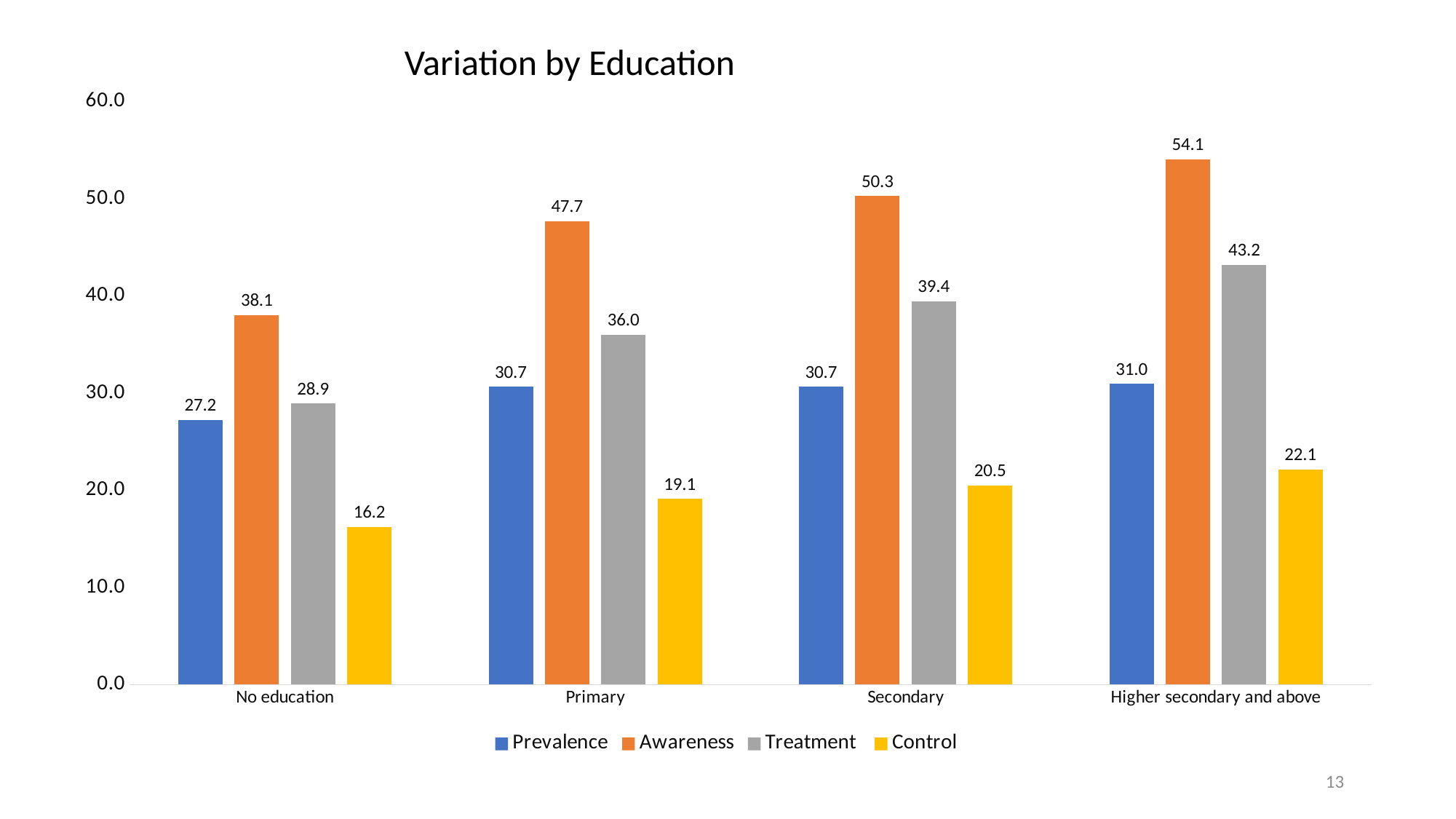
What is the difference between the Awareness and Prevalence values for the Secondary group? 19.6 Which is larger: the Treatment value for Primary or the Treatment value for Secondary? Secondary What is the Awareness value for the Primary education group? 47.7 Do the Control values rise or fall as education level increases from No education to Higher secondary and above? Rise What is the Treatment value for Higher secondary and above? 43.2 What is the Control value for the No education group? 16.2 What kind of chart is shown on the slide? Bar chart How many series does the legend list? 4 Is the Control value for Higher secondary and above greater or less than 20.0? greater Which education group has the lowest Treatment value? No education Which education group has the highest Awareness value? Higher secondary and above How many education categories are shown on the x axis? 4